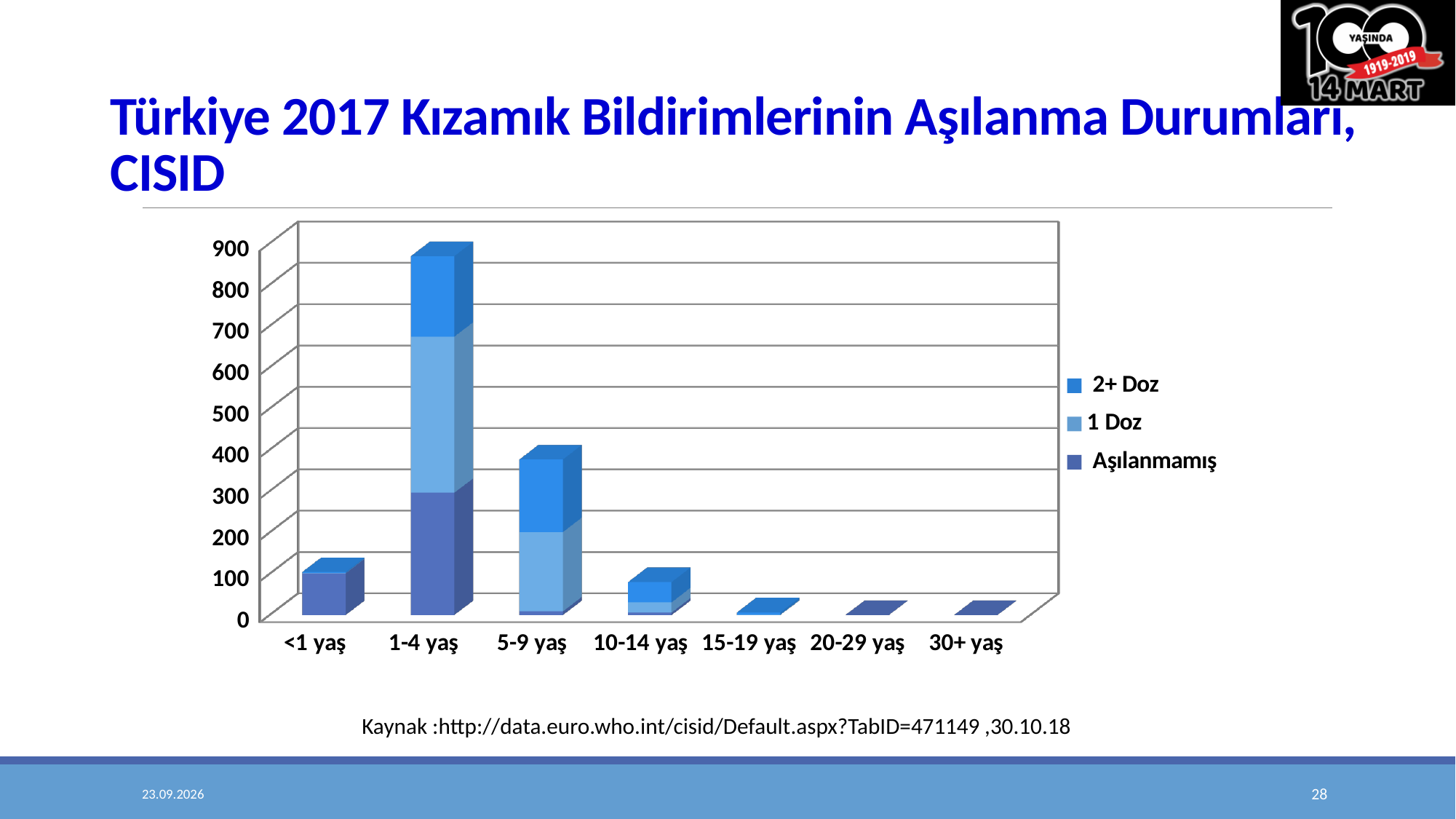
How many series does the chart's legend list? 3 Is the total value for 1-4 yaş greater or less than 800? greater What are the three series listed in the chart's legend? 2+ Doz, 1 Doz, Aşılanmamış What is the title of the slide containing the chart? Türkiye 2017 Kızamık Bildirimlerinin Aşılanma Durumları, CISID Which has the larger total bar, 1-4 yaş or 5-9 yaş? 1-4 yaş Is the total value for 10-14 yaş greater or less than 200? less Which has the larger total bar, 5-9 yaş or 10-14 yaş? 5-9 yaş What kind of chart is shown on the slide? Stacked bar chart How many age groups are shown on the x axis of the chart? 7 Is the total value for 5-9 yaş greater or less than 300? greater Which age group has the highest total bar in the chart? 1-4 yaş